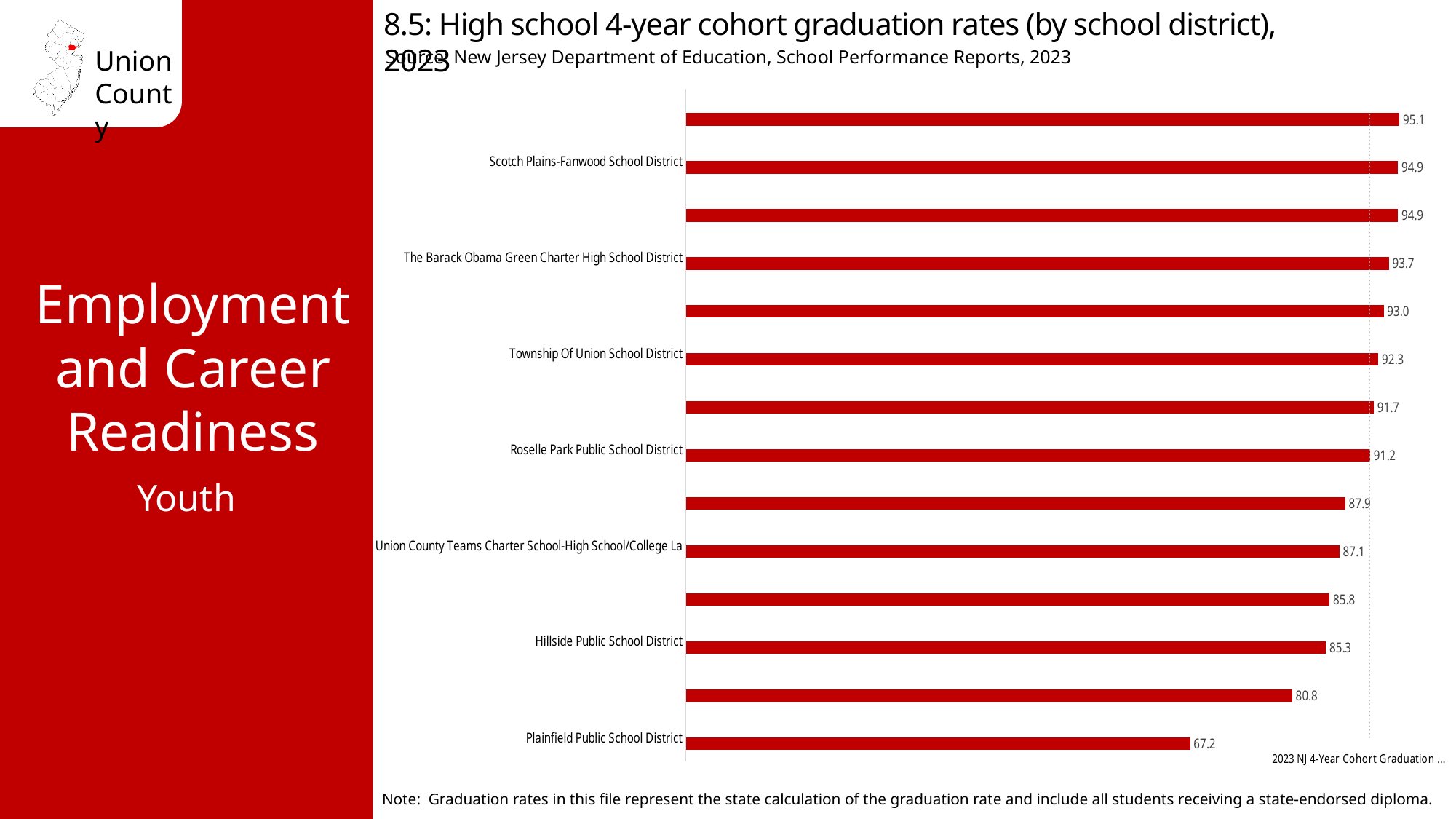
Which has a higher graduation rate, Township Of Union School District or Hillside Public School District? Township Of Union School District What is the graduation rate for Roselle Park Public School District? 91.2 What is the graduation rate for Hillside Public School District? 85.3 What is the difference between the graduation rates of The Barack Obama Green Charter High School District and Roselle Park Public School District? 2.5 What is the graduation rate for Township Of Union School District? 92.3 What kind of chart is shown on the slide? Bar chart What is the graduation rate for Scotch Plains-Fanwood School District? 94.9 What is the difference between the graduation rates of Scotch Plains-Fanwood School District and Plainfield Public School District? 27.7 What is the graduation rate for Plainfield Public School District? 67.2 What is the graduation rate for The Barack Obama Green Charter High School District? 93.7 How many bars are plotted on the chart? 14 Which school district has the lowest graduation rate on the chart? Plainfield Public School District